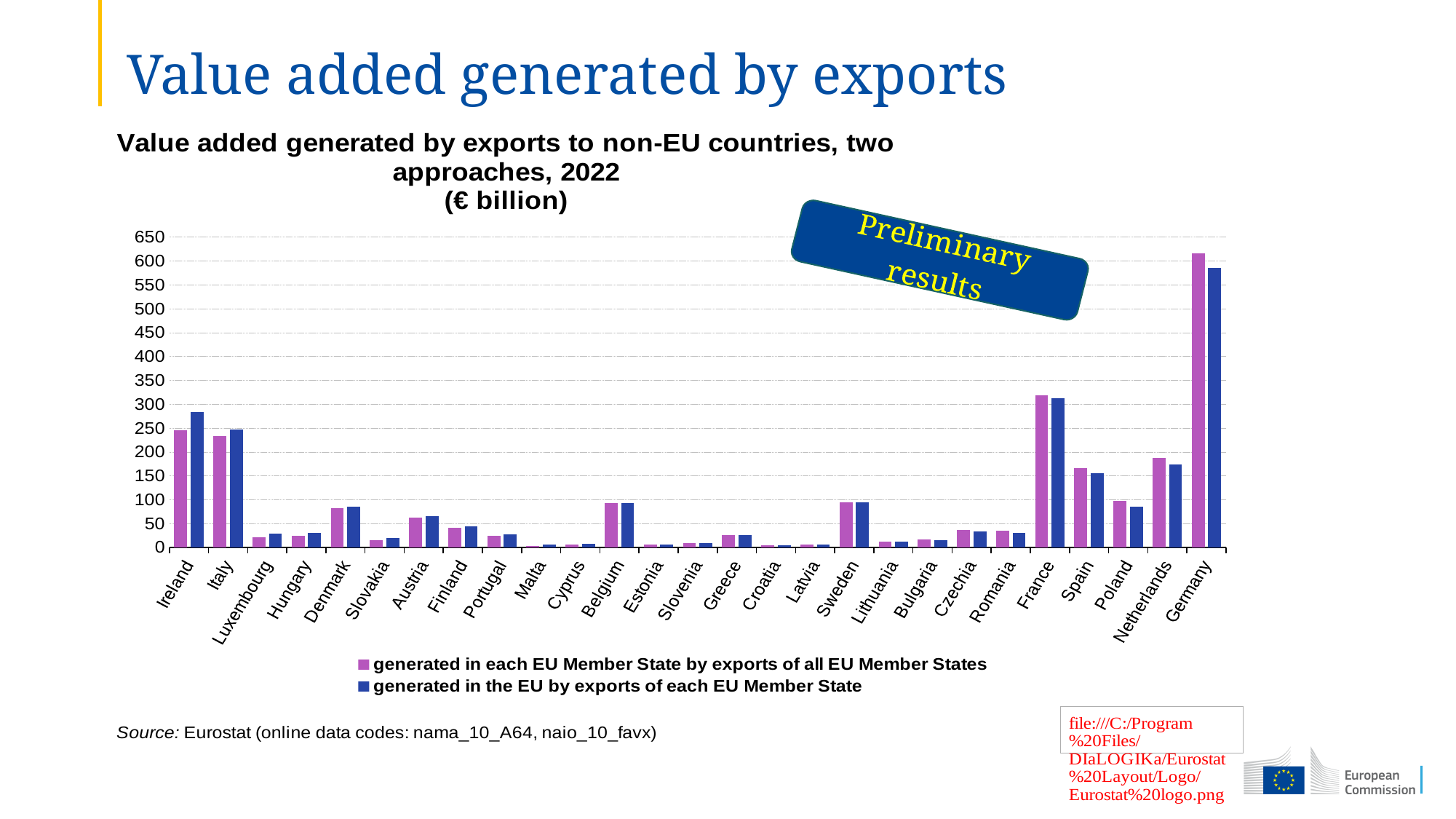
For Ireland, which series has the larger value: 'generated in each EU Member State by exports of all EU Member States' or 'generated in the EU by exports of each EU Member State'? generated in the EU by exports of each EU Member State How many countries are shown on the x axis? 27 Which country has the larger value for 'generated in each EU Member State by exports of all EU Member States': France or Netherlands? France What kind of chart is shown on the slide? bar chart Is the value for France in the series 'generated in each EU Member State by exports of all EU Member States' greater or less than 300? greater What unit is given in the chart title? € billion Is the value for Germany in the series 'generated in each EU Member State by exports of all EU Member States' greater or less than 600? greater How many series does the legend list? 2 Is the value for Belgium in the series 'generated in the EU by exports of each EU Member State' greater or less than 100? less Which country has the highest value for 'generated in each EU Member State by exports of all EU Member States'? Germany Which country has the highest value for 'generated in the EU by exports of each EU Member State'? Germany